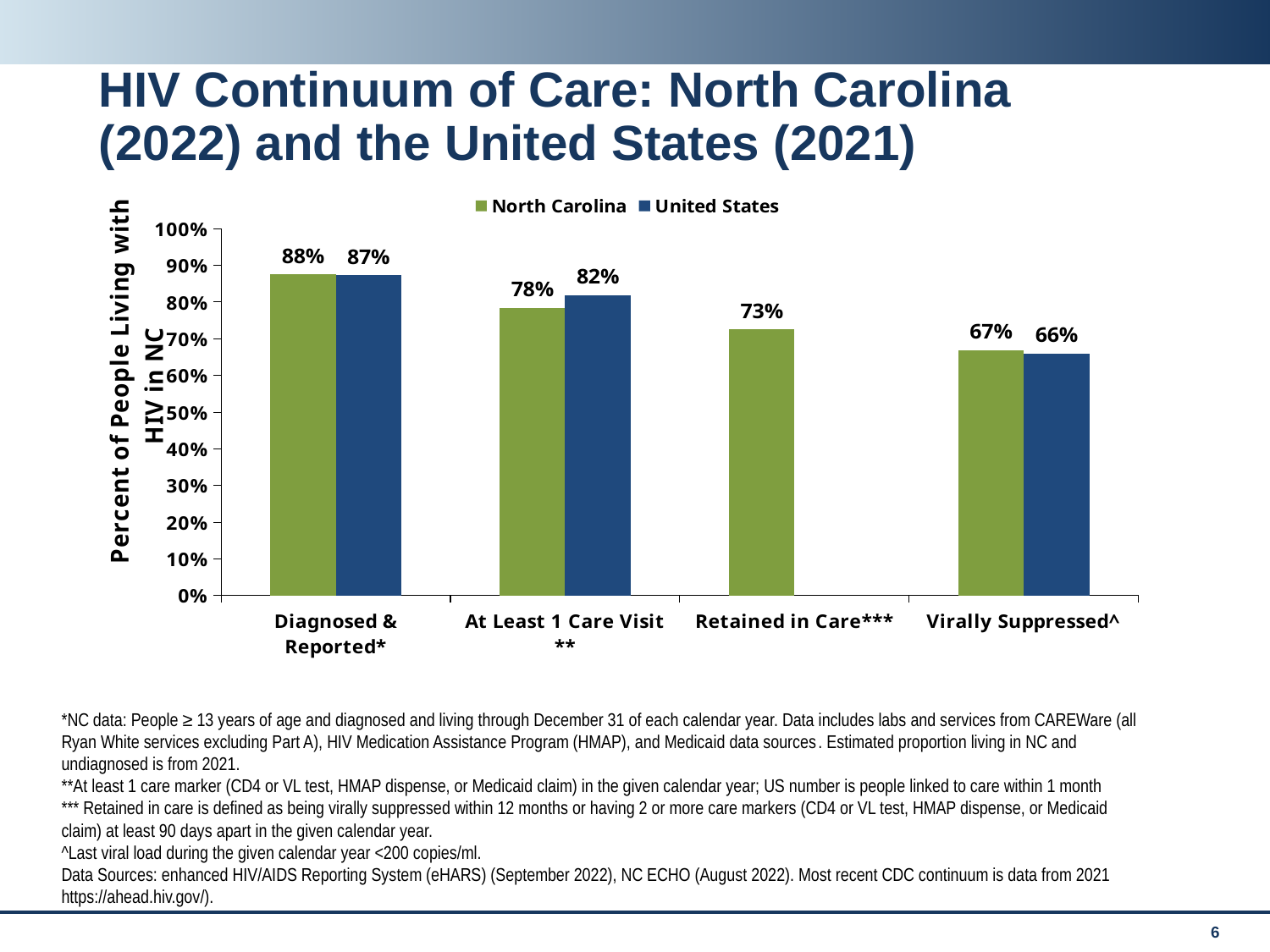
What is the United States value for At Least 1 Care Visit **? 82% Which is larger for Diagnosed & Reported*: the North Carolina value or the United States value? North Carolina What is the North Carolina value for Diagnosed & Reported*? 88% What is the North Carolina value for Retained in Care***? 73% Which category has the lowest United States value? Virally Suppressed^ Do the North Carolina values rise or fall from left to right across the categories? Fall How many categories are shown on the x axis? 4 Which category has the highest North Carolina value? Diagnosed & Reported* What is the United States value for Virally Suppressed^? 66% How many series does the legend list? 2 What kind of chart is shown on the slide? Bar chart What is the difference between the United States and North Carolina values for At Least 1 Care Visit **? 4%